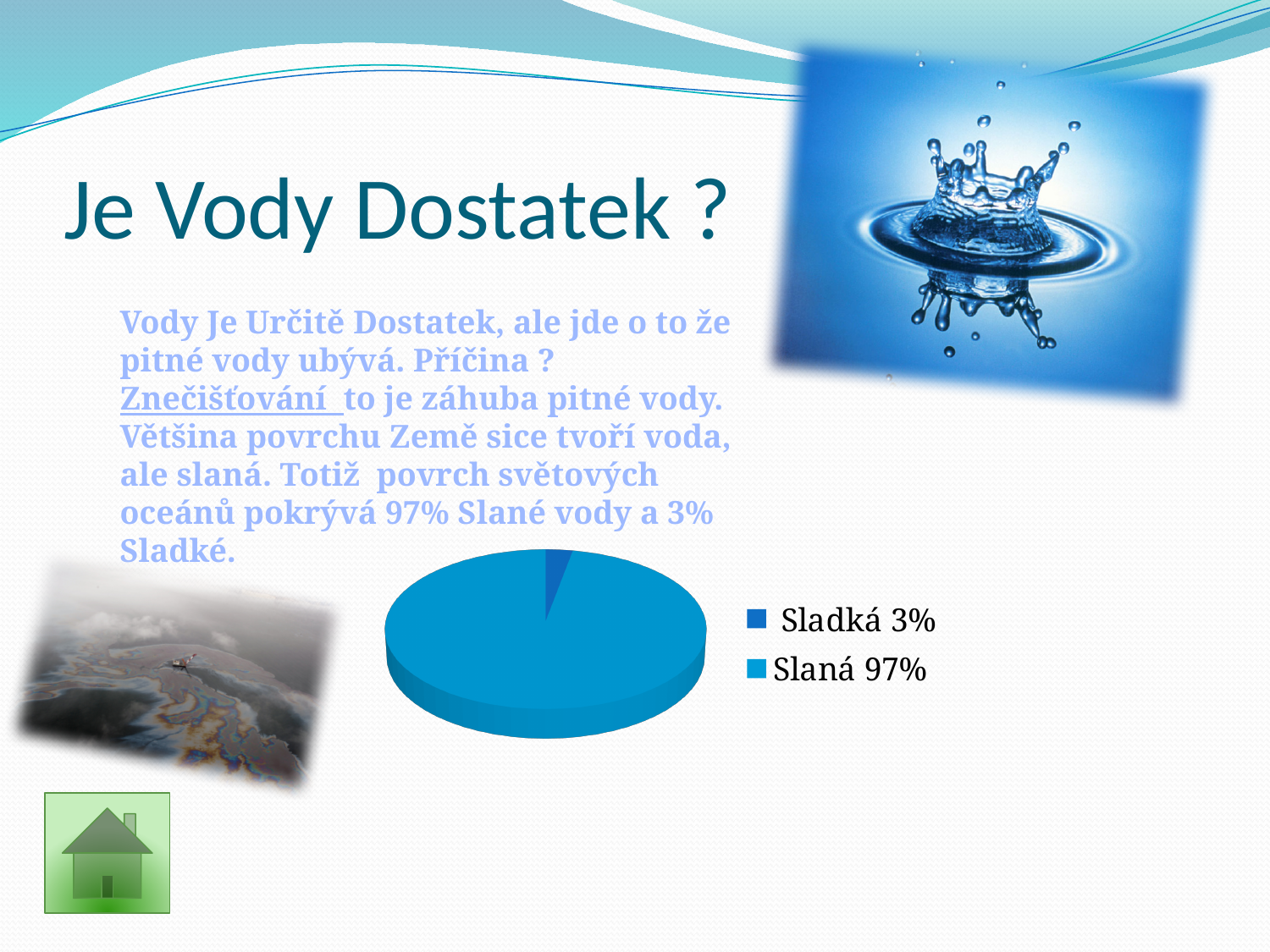
How many slices does the pie chart have? 2 What percentage does the pie chart show for Sladká? 3% What are the two legend entries of the pie chart? Sladká 3% and Slaná 97% Which is larger in the pie chart, Sladká or Slaná? Slaná What share of the pie does the Slaná slice represent? 97% How many entries does the legend of the pie chart list? 2 What percentage does the pie chart show for Slaná? 97% What kind of chart is shown on the slide? pie chart What is the difference in percentage points between Slaná and Sladká in the pie chart? 94 Which slice of the pie chart is the largest? Slaná Which slice of the pie chart is the smallest? Sladká Which legend entry of the pie chart is listed first? Sladká 3%